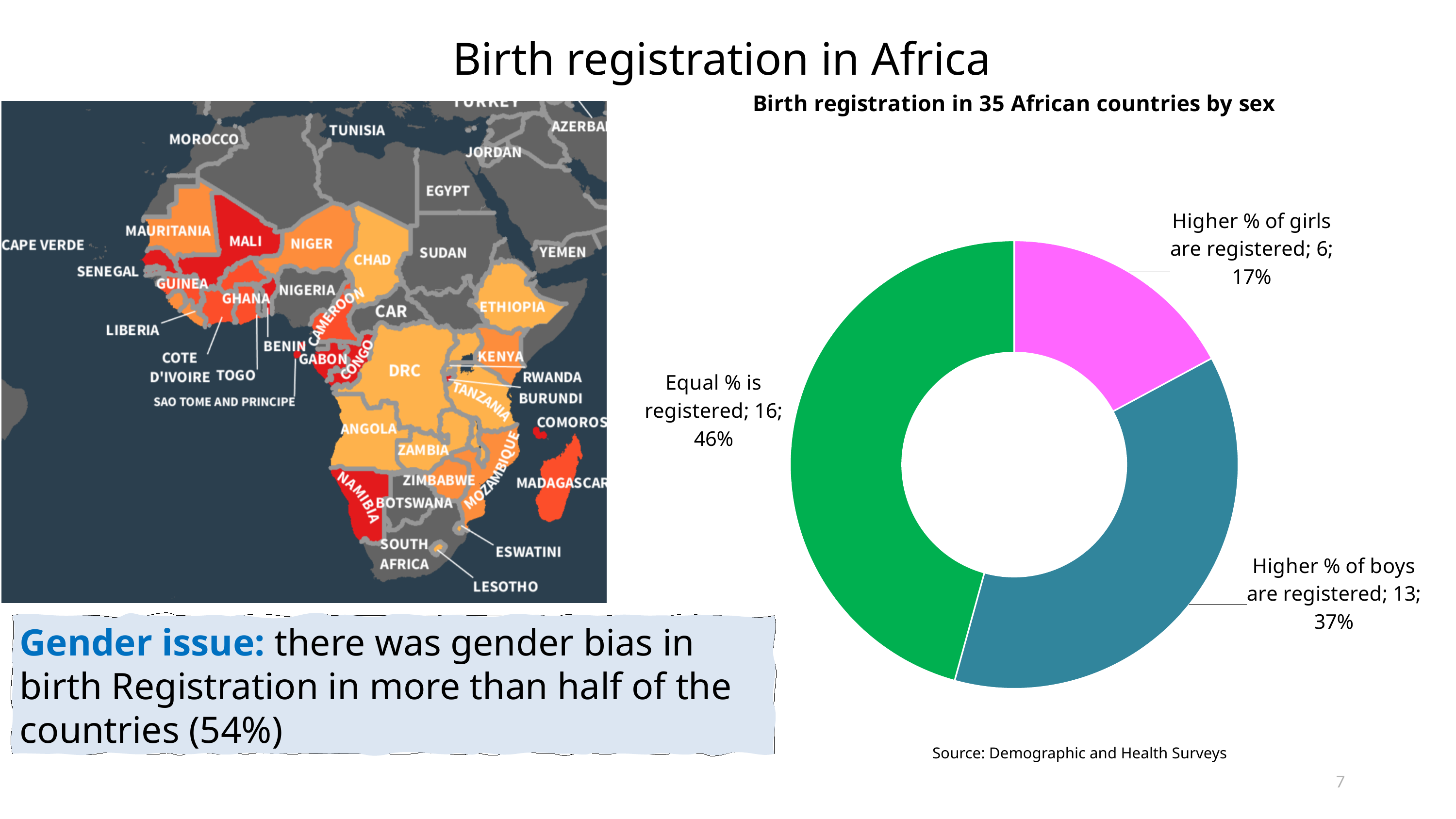
How many categories does the doughnut chart show? 3 How many countries have a higher % of girls registered? 6 Which category has the smallest slice in the doughnut chart? Higher % of girls are registered How many countries have an equal % registered? 16 How many more countries have a higher % of boys registered than a higher % of girls registered? 7 How many countries have a higher % of boys registered? 13 Which is larger: the number of countries with a higher % of boys registered or with an equal % registered? Equal % is registered Which category has the largest slice in the doughnut chart? Equal % is registered What share of the doughnut chart is 'Higher % of boys are registered'? 37% What share of the doughnut chart is 'Equal % is registered'? 46% What type of chart is used to show birth registration in 35 African countries by sex? Doughnut chart What share of the doughnut chart is 'Higher % of girls are registered'? 17%